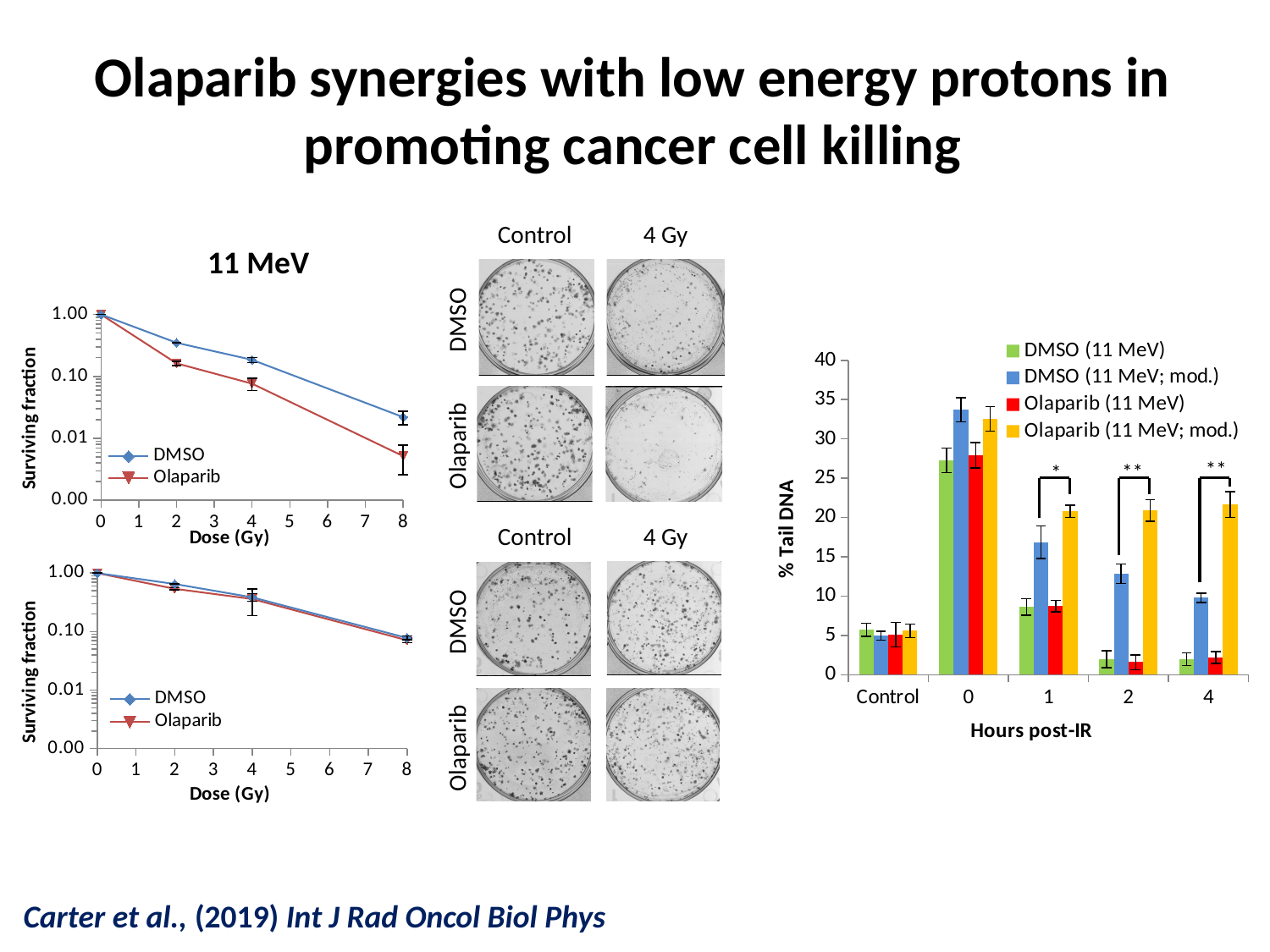
In the right-hand bar chart, which series has the highest value at 4 hours post-IR? Olaparib (11 MeV; mod.) What is the x-axis title of the bottom-left line chart? Dose (Gy) In the right-hand bar chart, is the value for Olaparib (11 MeV) at 2 hours post-IR greater or less than 5? less How many series does the legend of the right-hand bar chart list? 4 What is the title of the top-left line chart? 11 MeV How many categories are shown on the x axis of the right-hand bar chart? 5 In the top-left line chart titled 11 MeV, at 8 Gy which series has the larger surviving fraction: DMSO or Olaparib? DMSO In the right-hand bar chart, is the value for DMSO (11 MeV; mod.) at 0 hours post-IR greater or less than 30? greater What kind of chart is the chart on the right of the slide (% Tail DNA vs Hours post-IR)? bar chart In the right-hand bar chart, at 1 hour post-IR, which is larger: DMSO (11 MeV; mod.) or Olaparib (11 MeV; mod.)? Olaparib (11 MeV; mod.) How many series does the legend of the top-left line chart list? 2 In the top-left line chart titled 11 MeV, does the surviving fraction for DMSO rise or fall as the dose increases? fall